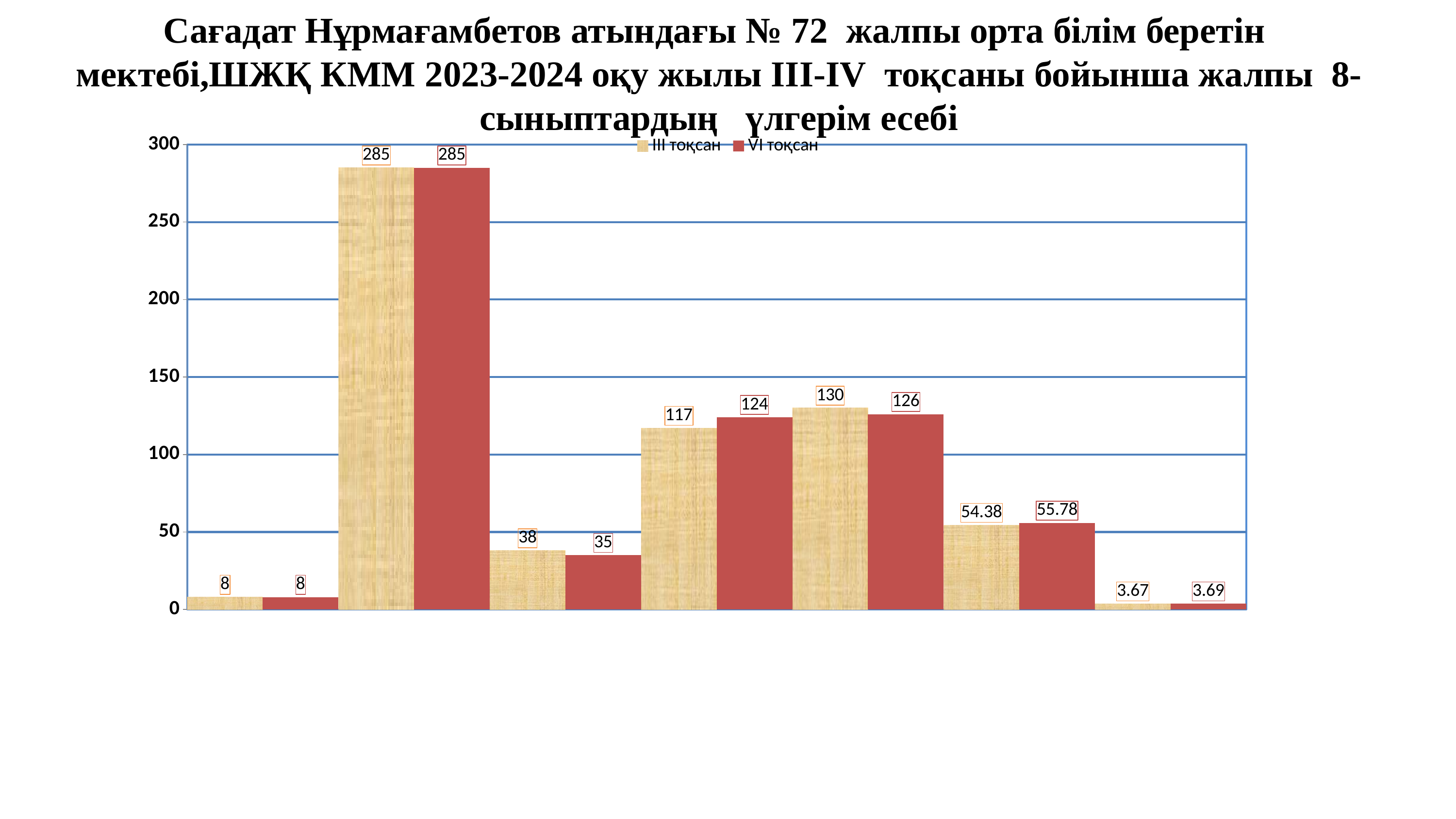
What is the value of the VI тоқсан bar in the fourth group of bars from the left? 124 What is the value of the III тоқсан bar in the sixth group of bars from the left? 54.38 Which group of bars has the highest values in the chart? the second group from the left What are the two series names shown in the legend? III тоқсан and VI тоқсан What is the value of the III тоқсан bar in the second group of bars from the left? 285 How many series does the legend list? 2 What kind of chart is shown on the slide? bar chart In the fourth group of bars from the left, which series has the larger value, III тоқсан or VI тоқсан? VI тоқсан In the fifth group of bars from the left, which series has the larger value, III тоқсан or VI тоқсан? III тоқсан In the third group of bars from the left, what is the difference between the III тоқсан value and the VI тоқсан value? 3 How many groups of bars are plotted in the chart? 7 What is the value of the VI тоқсан bar in the last group of bars on the right? 3.69